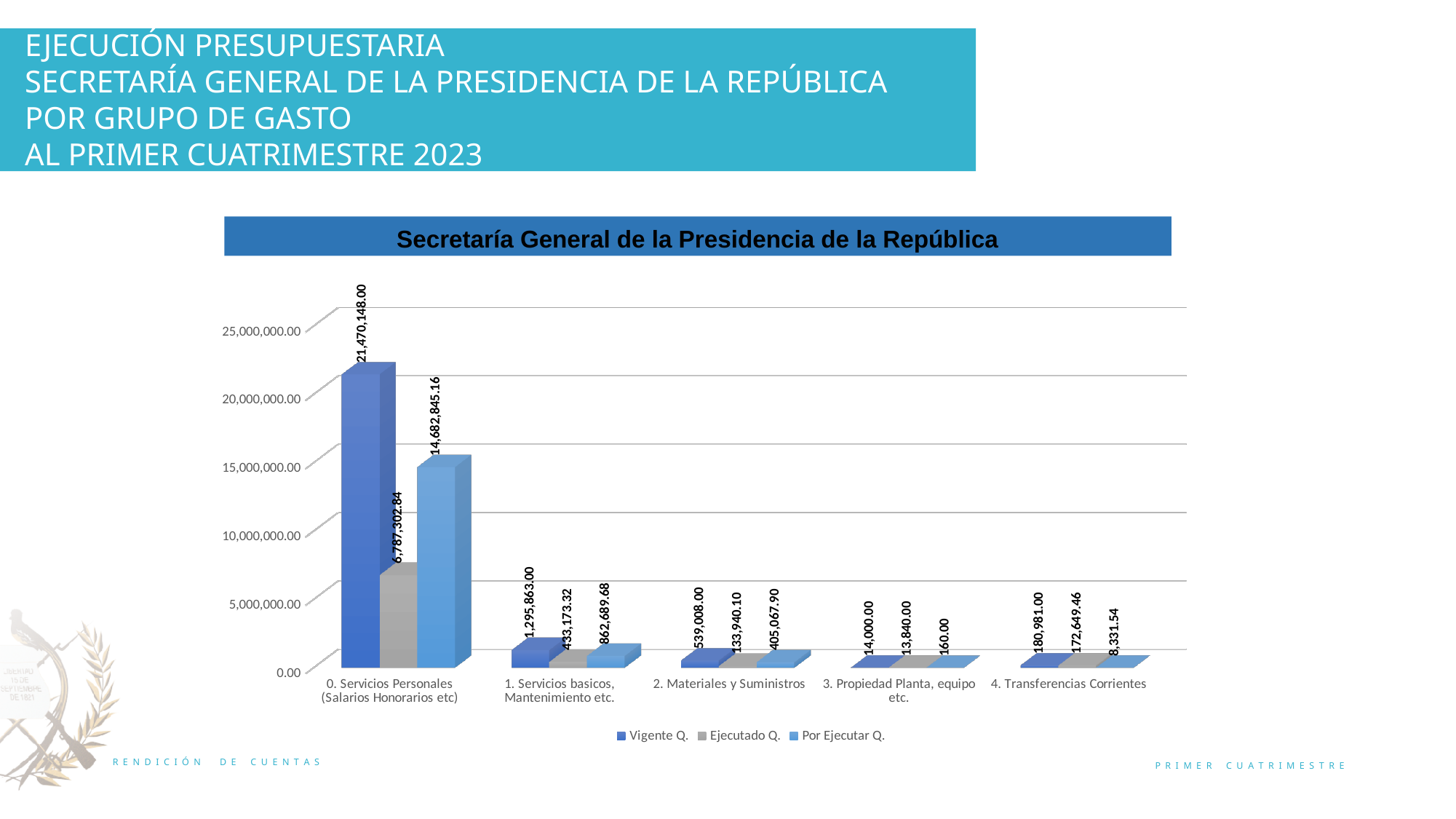
Which category has the lowest Por Ejecutar Q. value? 3. Propiedad Planta, equipo etc. How many expense group categories are shown on the x axis? 5 What is the Por Ejecutar Q. value for 2. Materiales y Suministros? 405,067.90 What is the Ejecutado Q. value for 4. Transferencias Corrientes? 172,649.46 Which category has the highest Vigente Q. value? 0. Servicios Personales (Salarios Honorarios etc) What is the difference between the Vigente Q. and Ejecutado Q. values for 0. Servicios Personales (Salarios Honorarios etc)? 14,682,845.16 How many series does the legend list? 3 Is the Por Ejecutar Q. value for 0. Servicios Personales (Salarios Honorarios etc) greater or less than 10,000,000.00? greater Which is larger for 4. Transferencias Corrientes: the Ejecutado Q. value or the Por Ejecutar Q. value? Ejecutado Q. What type of chart is shown on the slide? Bar chart What is the Ejecutado Q. value for 1. Servicios basicos, Mantenimiento etc.? 433,173.32 What is the Vigente Q. value for 0. Servicios Personales (Salarios Honorarios etc)? 21,470,148.00